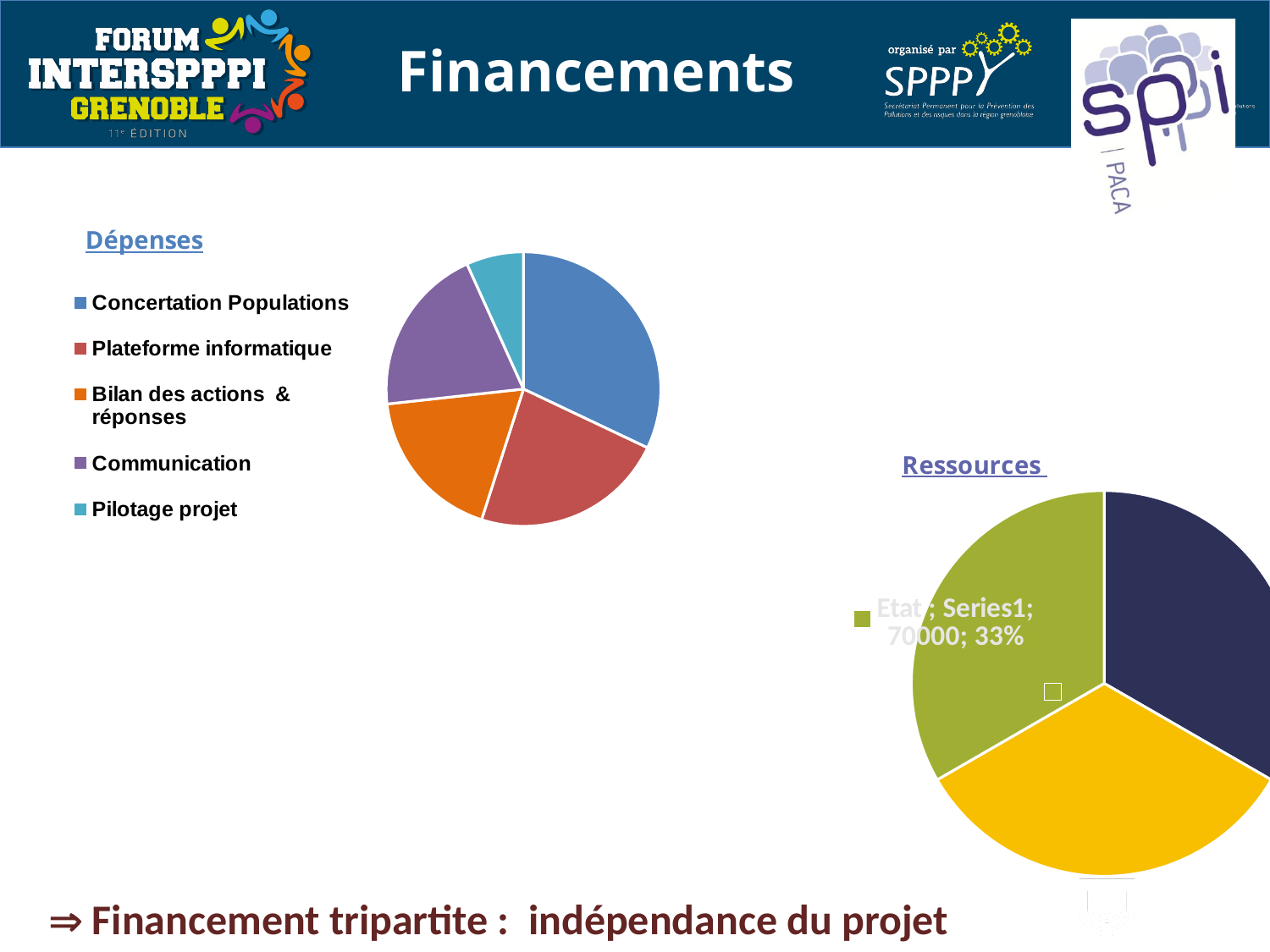
What kind of chart is the Ressources chart? pie chart What is the title of the pie chart on the right side of the slide? Ressources In the Dépenses chart, what colour is the Communication slice? purple In the Dépenses chart, which category has the largest slice? Concertation Populations In the Ressources chart, what value is shown for Etat? 70000 How many categories does the legend of the Dépenses chart list? 5 What kind of chart is the Dépenses chart? pie chart How many slices does the Ressources pie chart have? 3 In the Dépenses chart, which category has the smallest slice? Pilotage projet In the Dépenses chart, which slice is larger: Concertation Populations or Pilotage projet? Concertation Populations In the Dépenses chart, which slice is larger: Plateforme informatique or Pilotage projet? Plateforme informatique In the Ressources chart, what share of the pie does the Etat slice represent? 33%